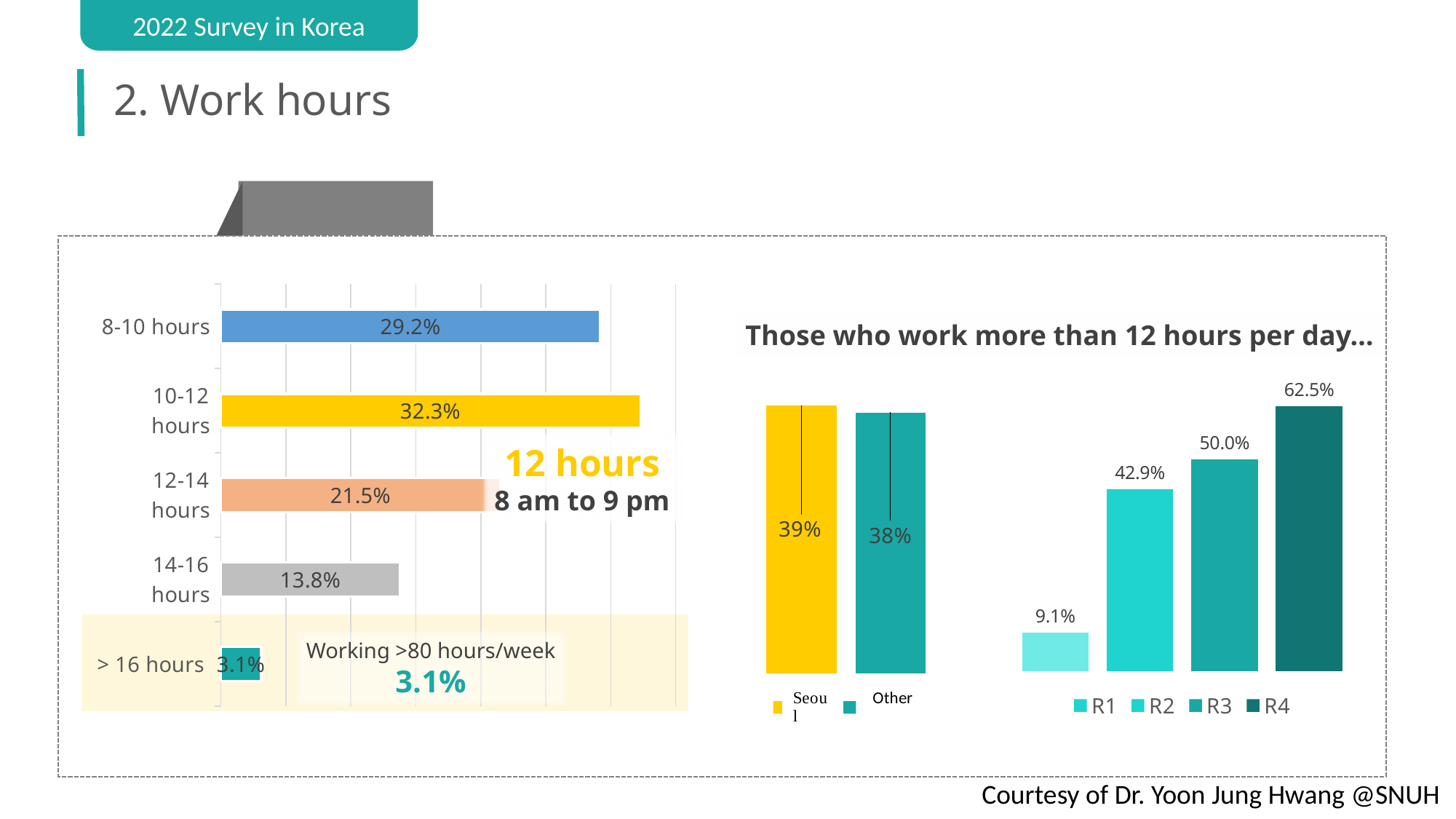
In the horizontal bar chart on the left, how many categories are shown? 5 In the right-hand chart with R1 to R4, what is the value for R2? 42.9% In the right-hand chart with R1 to R4, which category has the highest value? R4 In the right-hand chart with R1 to R4, what is the difference between R4 and R1? 53.4% In the right-hand chart with R1 to R4, do the values rise or fall from R1 to R4? rise In the middle chart comparing Seoul and Other, what is the value for Seoul? 39% In the horizontal bar chart on the left, which category has the lowest value? > 16 hours In the horizontal bar chart on the left, what is the value for 14-16 hours? 13.8% In the horizontal bar chart on the left, what is the difference between the values for 8-10 hours and 12-14 hours? 7.7% In the horizontal bar chart on the left, which category has the highest value? 10-12 hours In the horizontal bar chart on the left, what is the value for 10-12 hours? 32.3% In the middle chart comparing Seoul and Other, which of the two has the larger value? Seoul